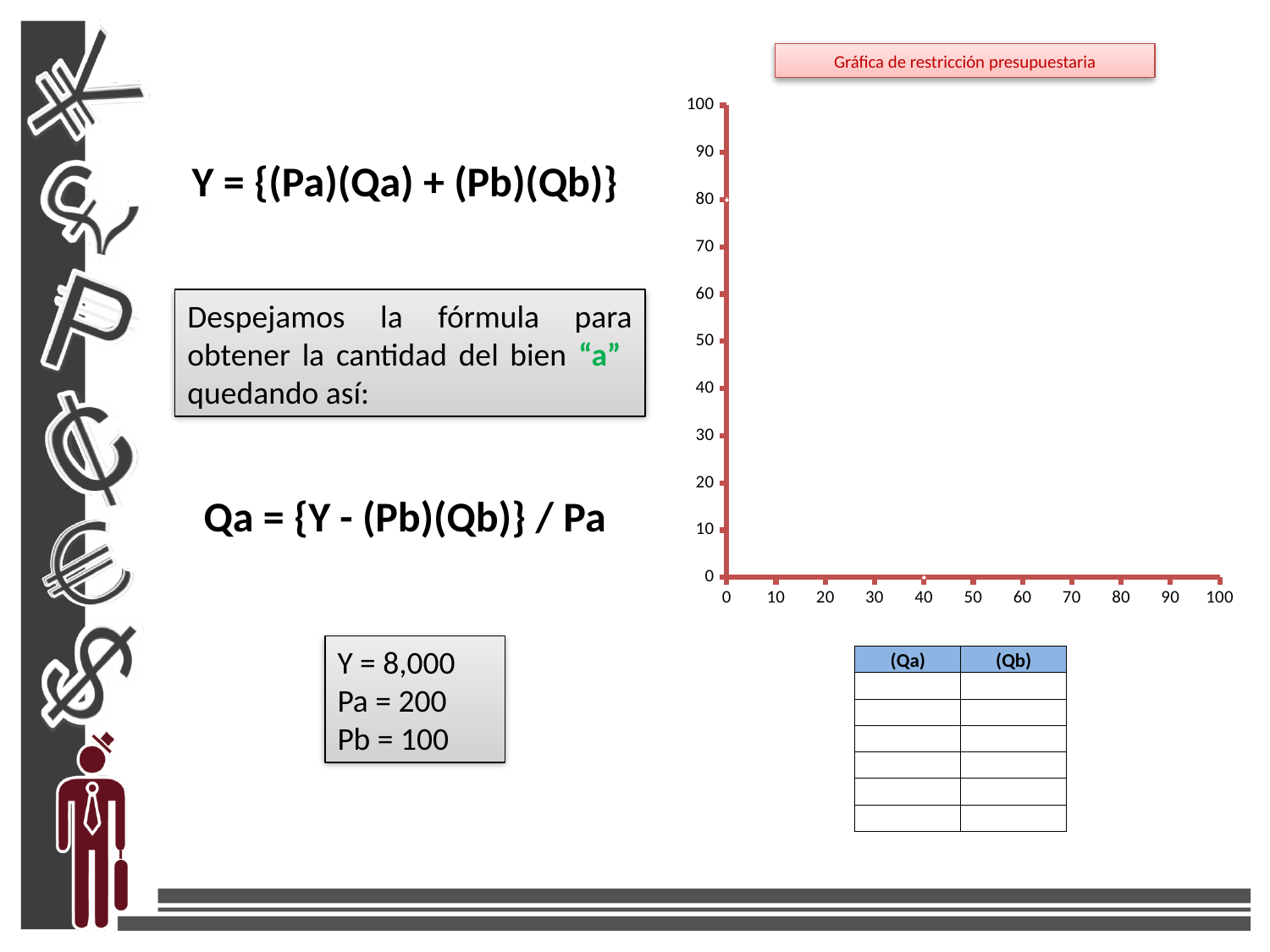
At what value on the horizontal axis does the plotted point on the horizontal axis lie? 40 What is the highest value shown on the vertical axis of the chart? 100 What is the title of the chart on the slide? Gráfica de restricción presupuestaria Which of the two plotted points has the larger vertical-axis value: the one on the vertical axis or the one on the horizontal axis? the one on the vertical axis Is the vertical-axis value of the point on the vertical axis greater or less than 50? greater At what value on the vertical axis does the plotted point on the vertical axis lie? 80 Is the horizontal-axis value of the point on the horizontal axis greater or less than 50? less